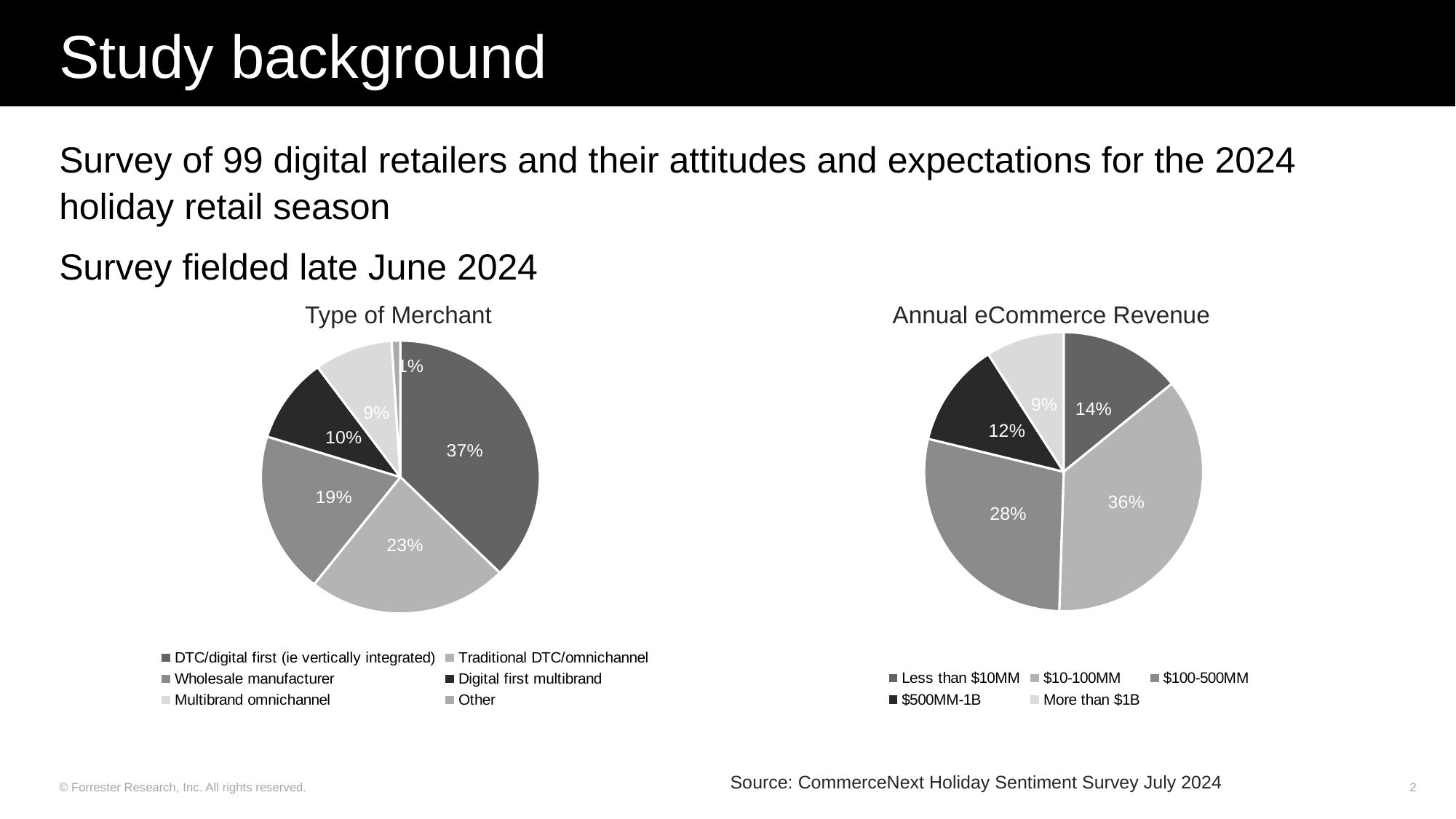
In the Type of Merchant chart, what share of respondents are DTC/digital first (ie vertically integrated)? 37% In the Type of Merchant chart, how many categories does the legend list? 6 How many charts are shown on the slide? 2 In the Annual eCommerce Revenue chart, which is larger: the $100-500MM share or the Less than $10MM share? $100-500MM In the Annual eCommerce Revenue chart, what share of respondents have revenue of $10-100MM? 36% In the Type of Merchant chart, what is the difference between the Traditional DTC/omnichannel share and the Digital first multibrand share? 13% In the Type of Merchant chart, what percentage are Wholesale manufacturer? 19% What type of chart is the Annual eCommerce Revenue chart? Pie chart In the Type of Merchant chart, which category has the largest slice? DTC/digital first (ie vertically integrated) In the Annual eCommerce Revenue chart, what percentage have revenue of $500MM-1B? 12% In the Annual eCommerce Revenue chart, which revenue band has the smallest share? More than $1B In the Type of Merchant chart, which category has the smallest slice? Other